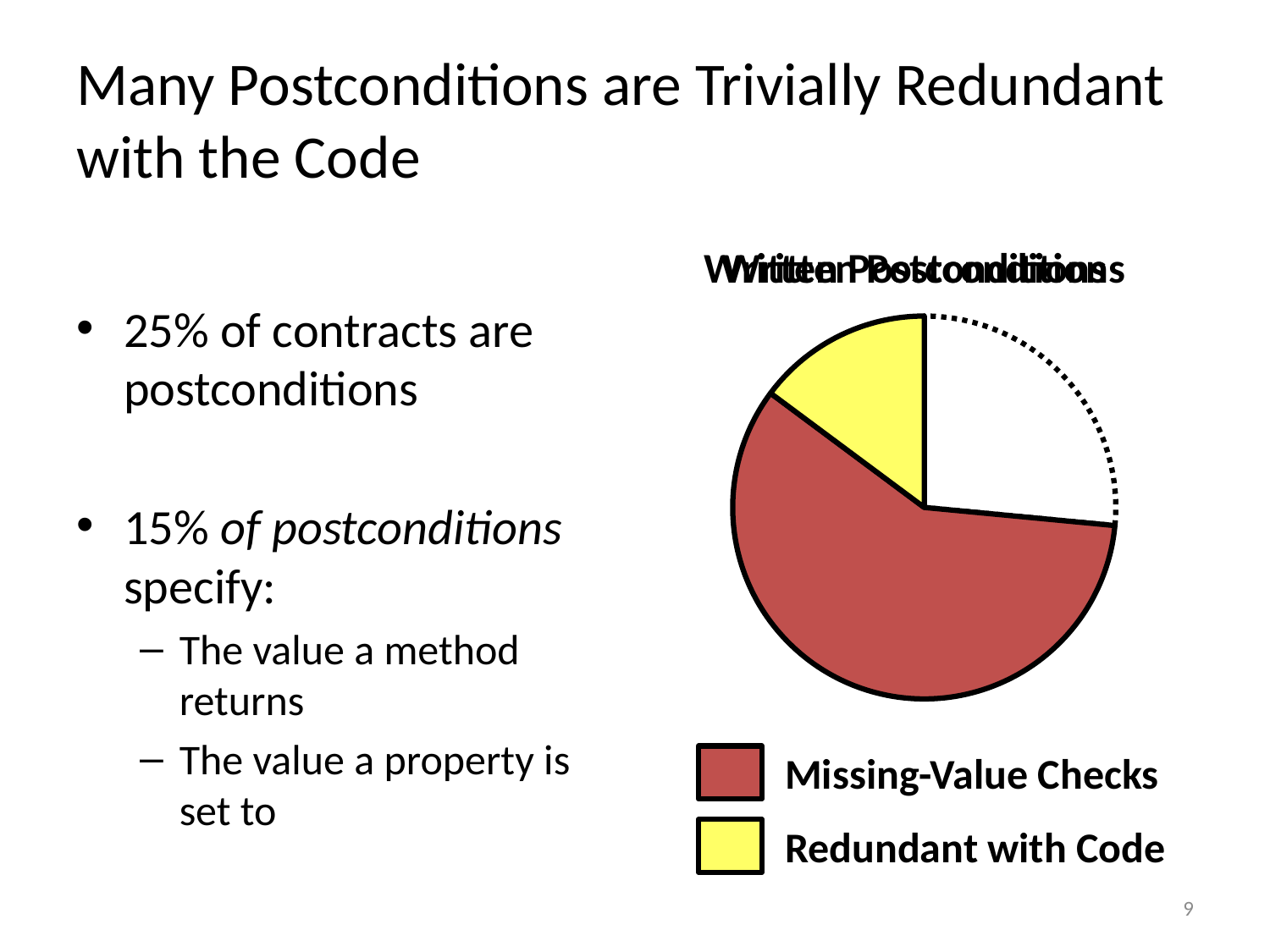
How many entries does the legend of the pie chart list? 2 What colour represents Missing-Value Checks in the pie chart? red What colour represents Redundant with Code in the pie chart? yellow Which legend category has the smallest slice in the pie chart? Redundant with Code Which legend category has the largest slice in the pie chart? Missing-Value Checks Which slice is larger in the pie chart, Missing-Value Checks or Redundant with Code? Missing-Value Checks What kind of chart is shown on the slide? pie chart